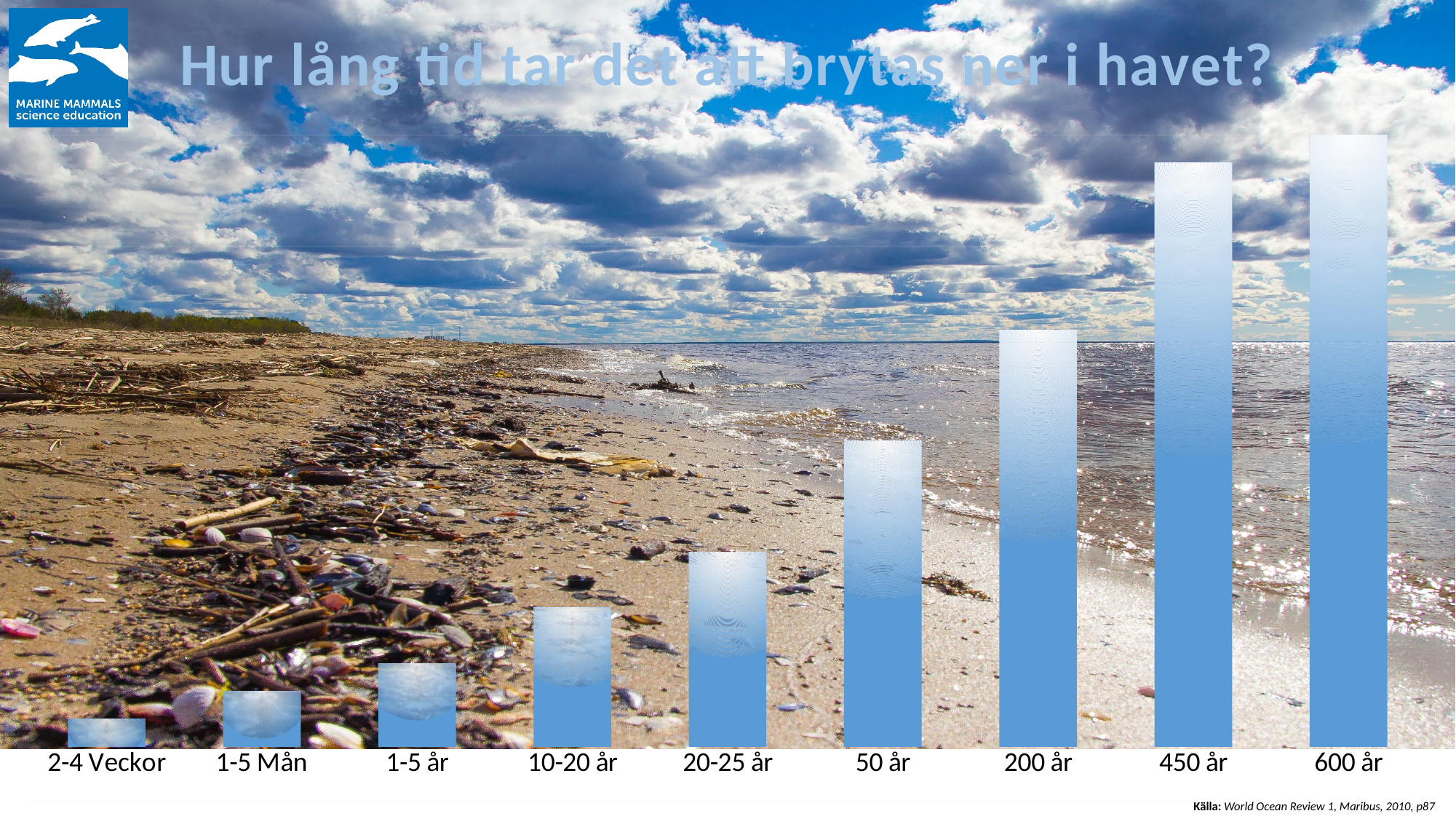
Which bar is shorter, the one for 50 år or the one for 20-25 år? 20-25 år Which category has the tallest bar? 600 år Which category has the shortest bar? 2-4 Veckor What kind of chart is shown on the slide? bar chart What is the title of the chart? Hur lång tid tar det att brytas ner i havet? What is the label of the second bar from the left? 1-5 Mån Which bar is taller, the one for 200 år or the one for 450 år? 450 år What source is cited for the chart? World Ocean Review 1, Maribus, 2010, p87 Do the bars rise or fall from left to right along the x axis? rise Which bar is taller, the one for 1-5 år or the one for 10-20 år? 10-20 år How many bars does the chart have? 9